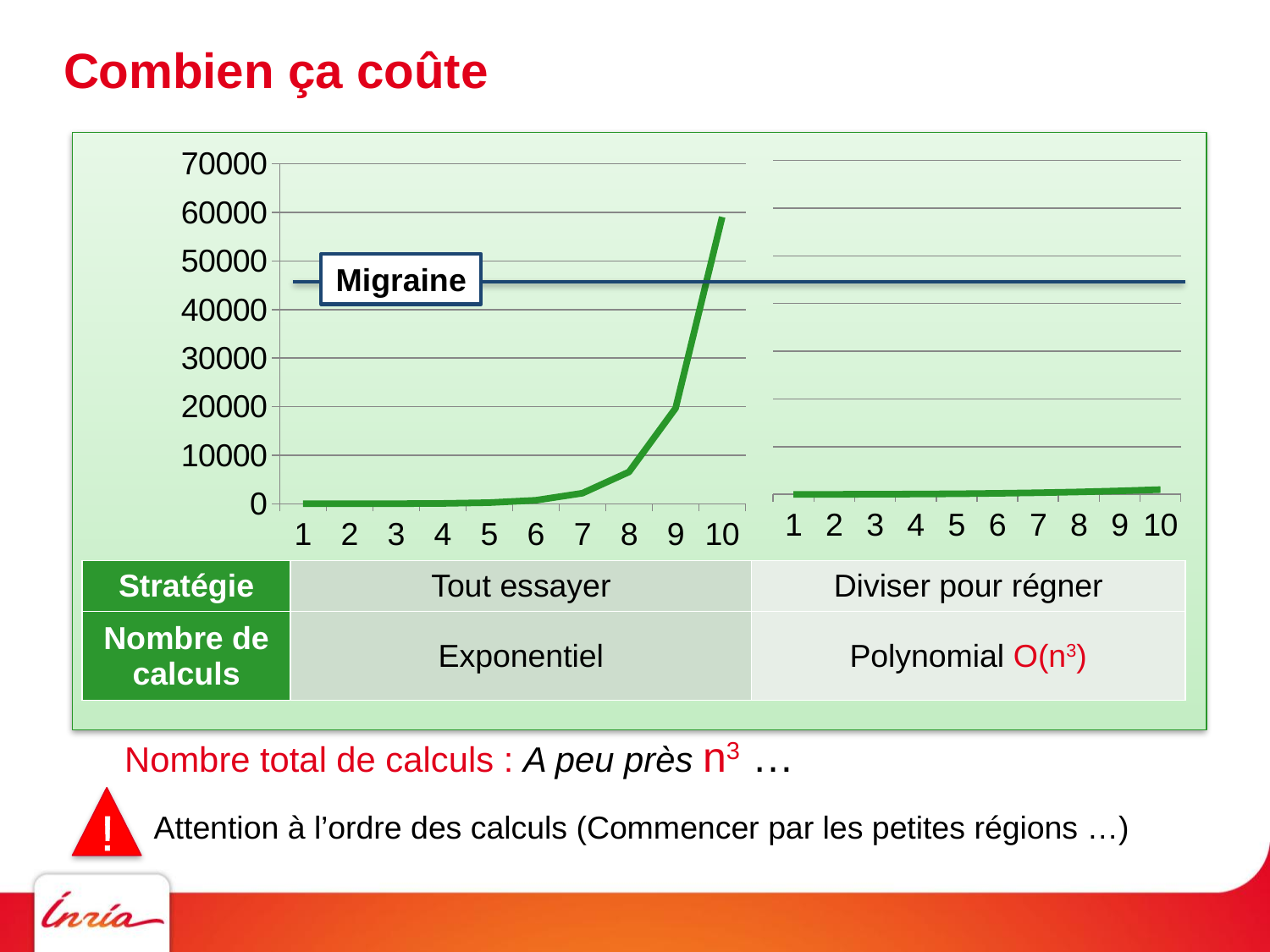
Which is larger at x = 10: the value in the left chart (Tout essayer) or the value in the right chart (Diviser pour régner)? Tout essayer What kind of chart is the right chart (Diviser pour régner)? line chart In the left chart (Tout essayer), do the values rise or fall as x goes from 1 to 10? rise In the left chart (Tout essayer), is the value at x = 8 greater or less than 10000? less What label is attached to the horizontal line drawn across the charts? Migraine In the left chart (Tout essayer), is the value at x = 9 greater or less than 30000? less In the left chart (Tout essayer), is the value at x = 10 greater or less than 50000? greater In the right chart (Diviser pour régner), how many x-axis categories are shown? 10 What is the highest value shown on the y axis of the charts? 70000 What kind of chart is the left chart (Tout essayer)? line chart In the left chart (Tout essayer), how many points are plotted along the x axis? 10